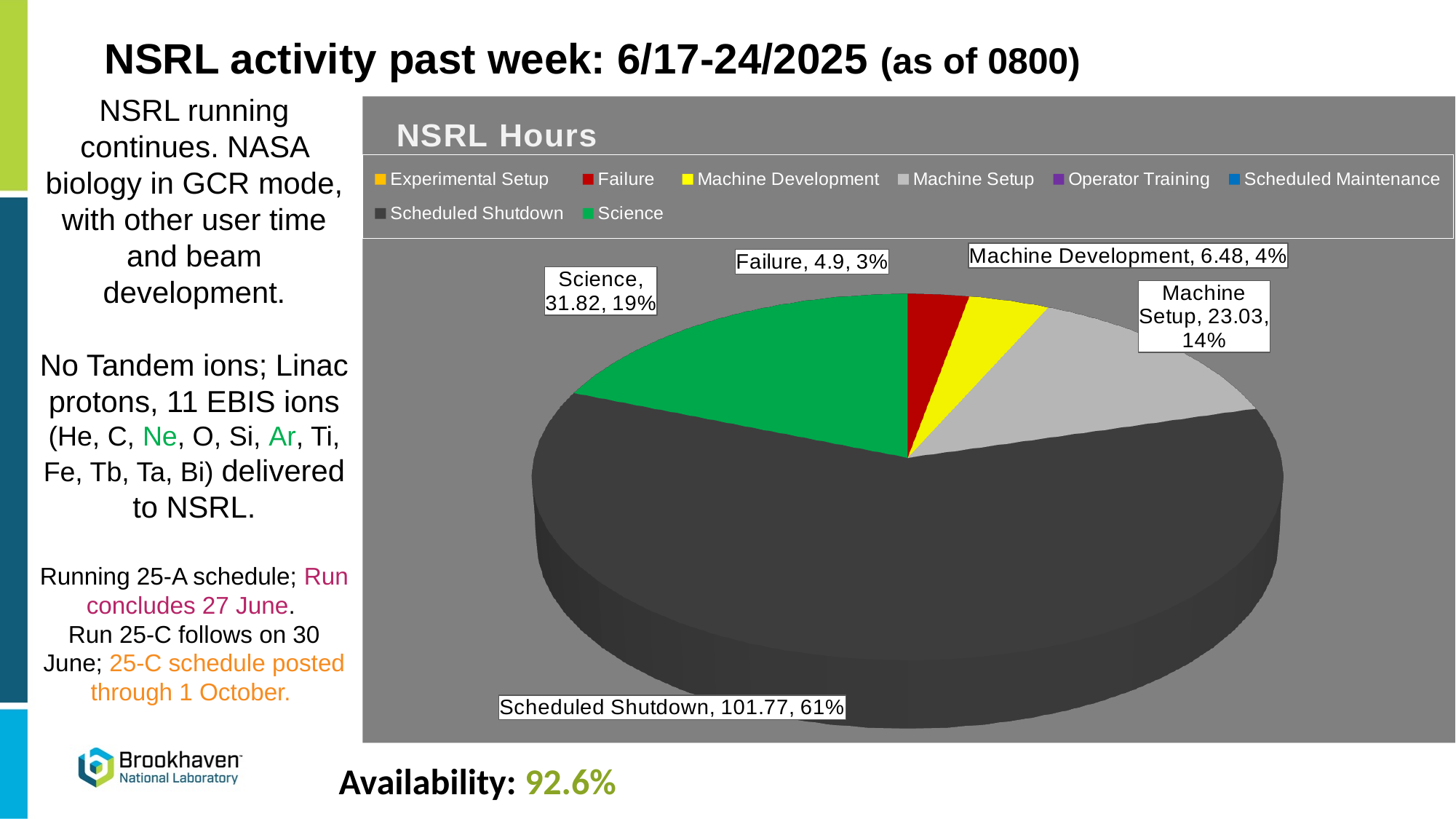
What percentage share of the pie does Failure have? 3% How many entries does the chart legend list? 8 How many hours are shown for Machine Setup? 23.03 What percentage share of the pie does Machine Development have? 4% How many hours are shown for Science? 31.82 Which category has the largest slice of the pie? Scheduled Shutdown Which labelled category has the smallest slice of the pie? Failure What kind of chart is shown on the slide? pie chart How many hours are shown for Scheduled Shutdown? 101.77 What is the difference in hours between Science and Machine Setup? 8.79 How many labelled slices are shown in the pie chart? 5 What is the title of the chart? NSRL Hours